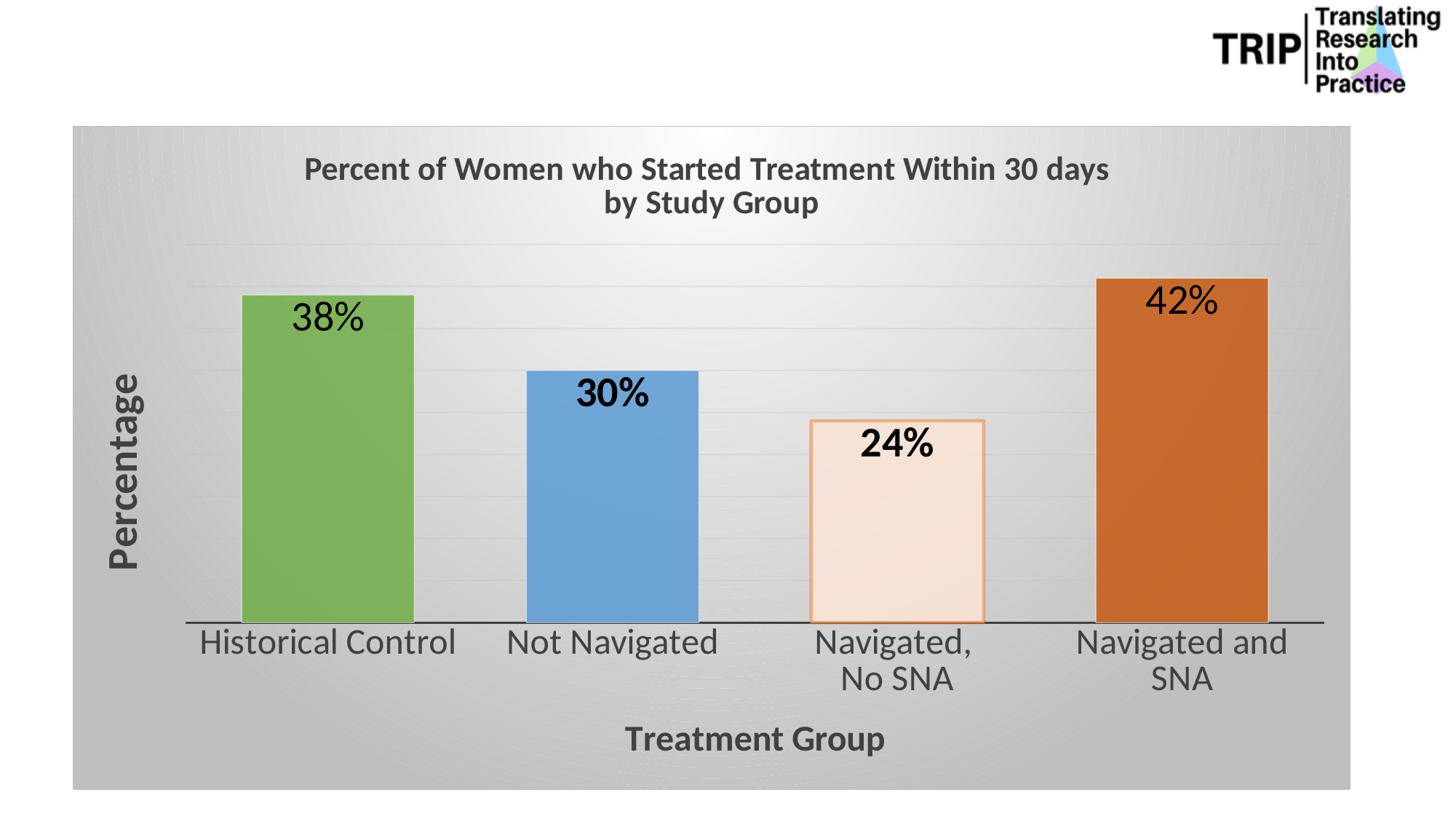
Which group has a higher value, Historical Control or Not Navigated? Historical Control What is the difference in percentage points between the Navigated and SNA group and the Navigated, No SNA group? 18 What is the value shown for the Navigated and SNA group? 42% What is the difference in percentage points between the Historical Control group and the Not Navigated group? 8 What is the value shown for the Not Navigated group? 30% Which study group has the highest percentage of women who started treatment within 30 days? Navigated and SNA What percentage of women in the Historical Control group started treatment within 30 days? 38% What kind of chart is shown on the slide? Bar chart How many study groups are shown in the chart? 4 What is the value shown for the Navigated, No SNA group? 24% Which study group has the lowest percentage of women who started treatment within 30 days? Navigated, No SNA What is the title of the chart? Percent of Women who Started Treatment Within 30 days by Study Group